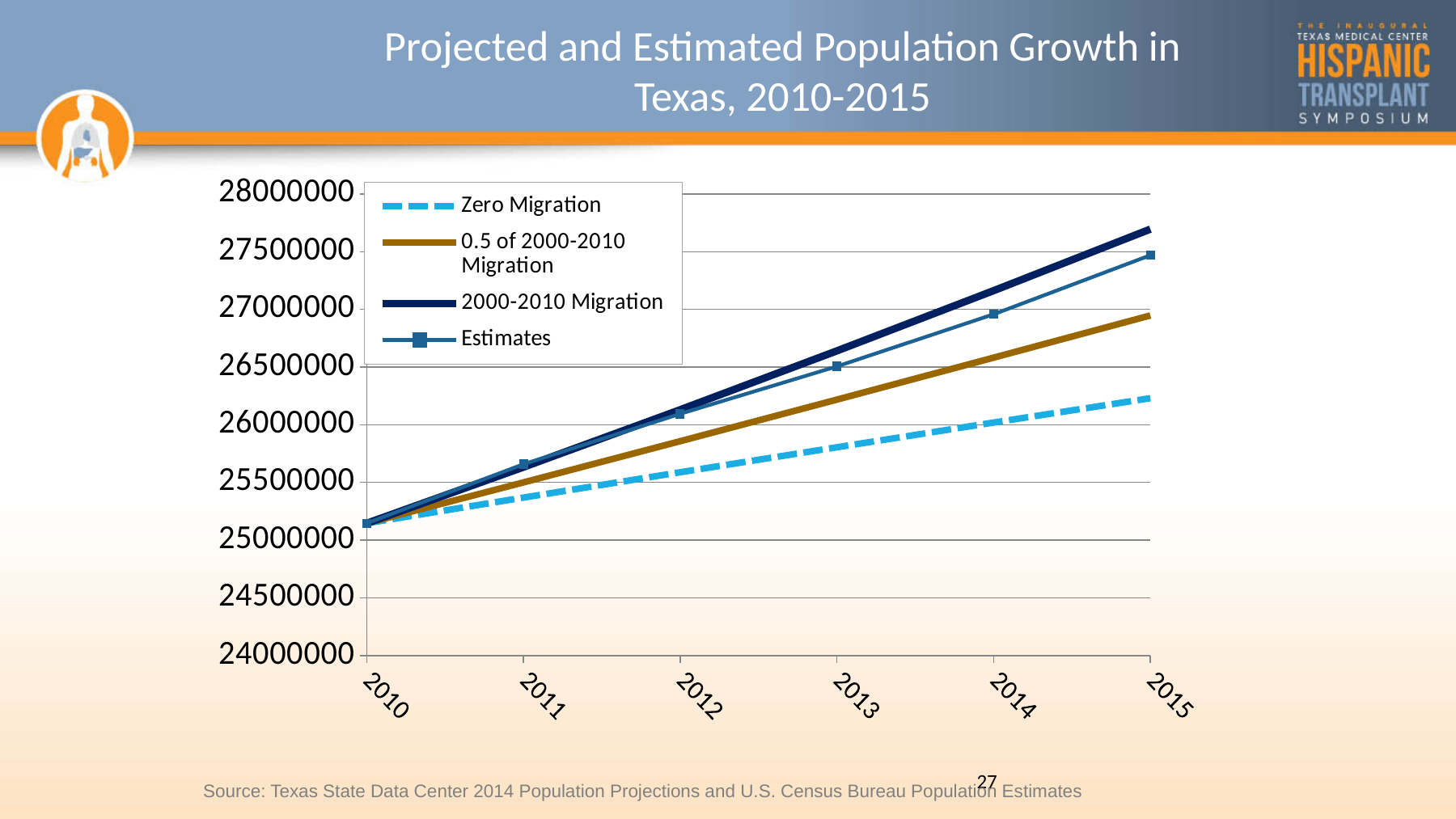
Is the value for 0.5 of 2000-2010 Migration in 2015 greater or less than 26500000? greater How many series does the legend list? 4 What kind of chart is shown on the slide? line chart Does the Zero Migration series rise or fall from 2010 to 2015? rise Is the value for Zero Migration in 2015 greater or less than 26500000? less Which series is drawn with a dashed line? Zero Migration How many years are shown on the x axis? 6 In 2015, which is larger: the Estimates value or the 0.5 of 2000-2010 Migration value? Estimates Which series has the lowest value in 2015? Zero Migration Is the value for Estimates in 2015 greater or less than 27000000? greater Which series has the highest value in 2015? 2000-2010 Migration